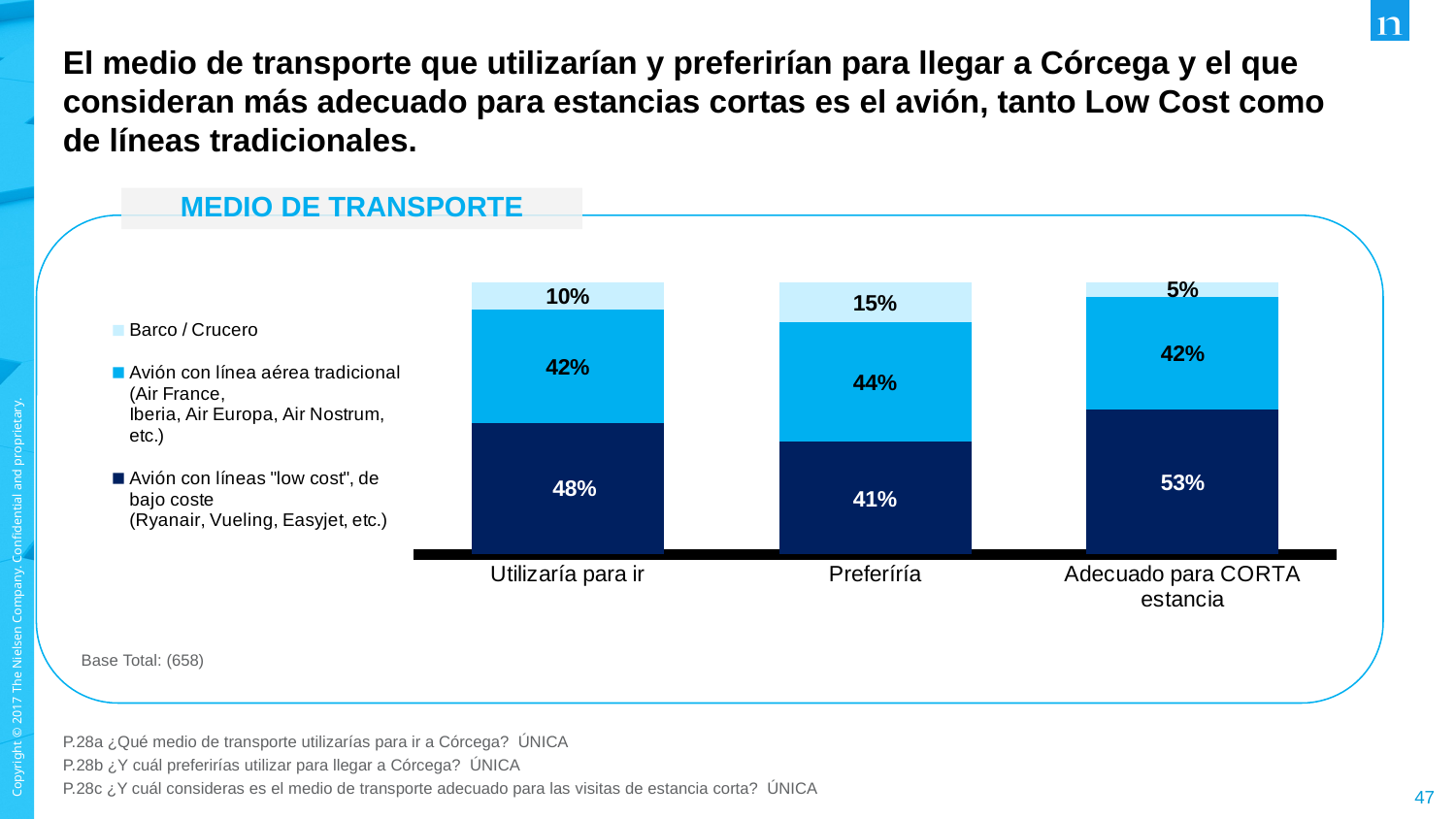
What is the title shown above the chart? MEDIO DE TRANSPORTE What is the total of the Utilizaría para ir stacked bar? 100% What percentage of respondents would use a low-cost airline (Avión con líneas "low cost") to go to Corsica (Utilizaría para ir)? 48% What is the value for Avión con línea aérea tradicional in the Adecuado para CORTA estancia bar? 42% In the Preferiría bar, which is larger: Avión con línea aérea tradicional or Avión con líneas "low cost"? Avión con línea aérea tradicional What is the difference between the low-cost airline values for Adecuado para CORTA estancia and Preferiría? 12% How many categories are shown on the x axis of the chart? 3 How many series does the legend list? 3 Which category has the highest value for Avión con líneas "low cost"? Adecuado para CORTA estancia What kind of chart is shown on the slide? Stacked bar chart What is the value for Barco / Crucero in the Preferiría bar? 15% Which category has the lowest value for Barco / Crucero? Adecuado para CORTA estancia